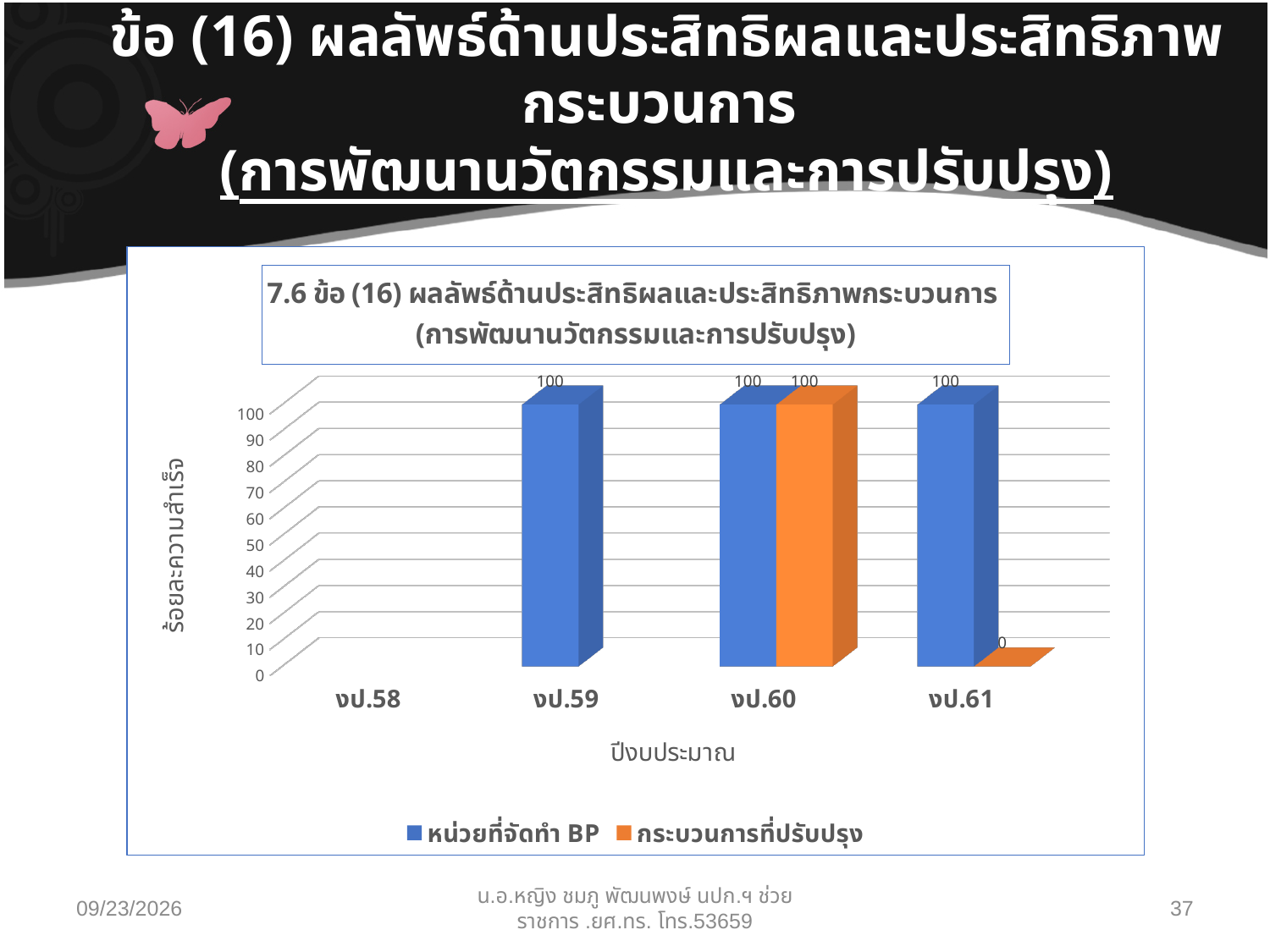
What is the value for กระบวนการที่ปรับปรุง in งป.61? 0 Which is larger in งป.61, หน่วยที่จัดทำ BP or กระบวนการที่ปรับปรุง? หน่วยที่จัดทำ BP How many series does the legend list? 2 What type of chart is shown on the slide? bar chart How many fiscal-year categories are shown on the x axis? 4 What is the value for กระบวนการที่ปรับปรุง in งป.60? 100 What is the value for หน่วยที่จัดทำ BP in งป.61? 100 What is the value for หน่วยที่จัดทำ BP in งป.59? 100 What is the difference between หน่วยที่จัดทำ BP and กระบวนการที่ปรับปรุง in งป.61? 100 Which colour represents the series กระบวนการที่ปรับปรุง? orange Which category has the lowest value for กระบวนการที่ปรับปรุง among those with a printed value? งป.61 What is the label of the y axis? ร้อยละความสำเร็จ